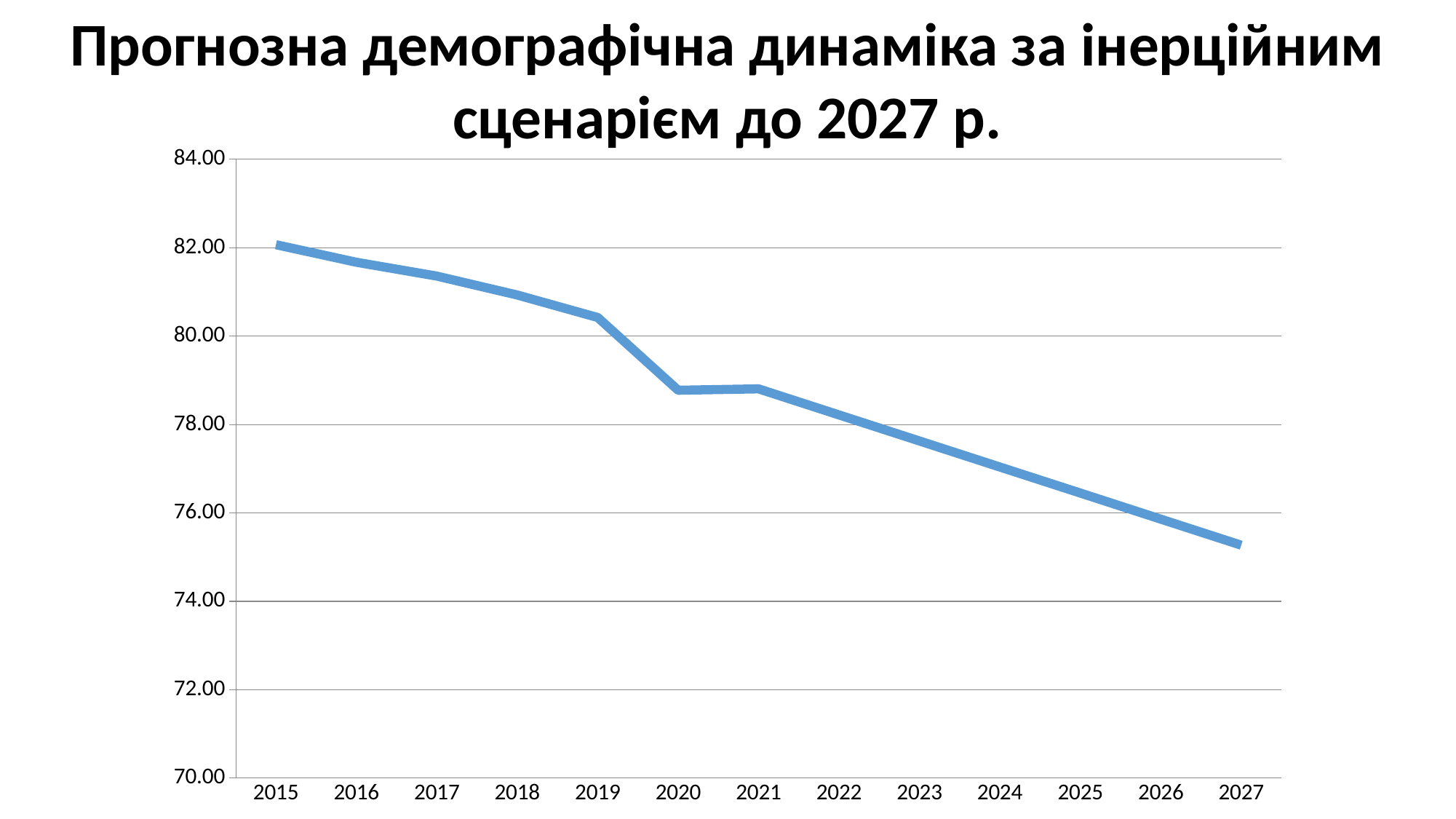
How many years are plotted along the x axis? 13 Is the value for 2015 greater or less than 80.00? greater Is the value for 2027 greater or less than 76.00? less Do the values rise or fall from 2015 to 2027? fall Which year has the highest value? 2015 Is the value for 2020 greater or less than 80.00? less Which is larger, the value for 2016 or the value for 2022? 2016 What is the title of the chart? Прогнозна демографічна динаміка за інерційним сценарієм до 2027 р. What kind of chart is shown on the slide? line chart Which year has the lowest value? 2027